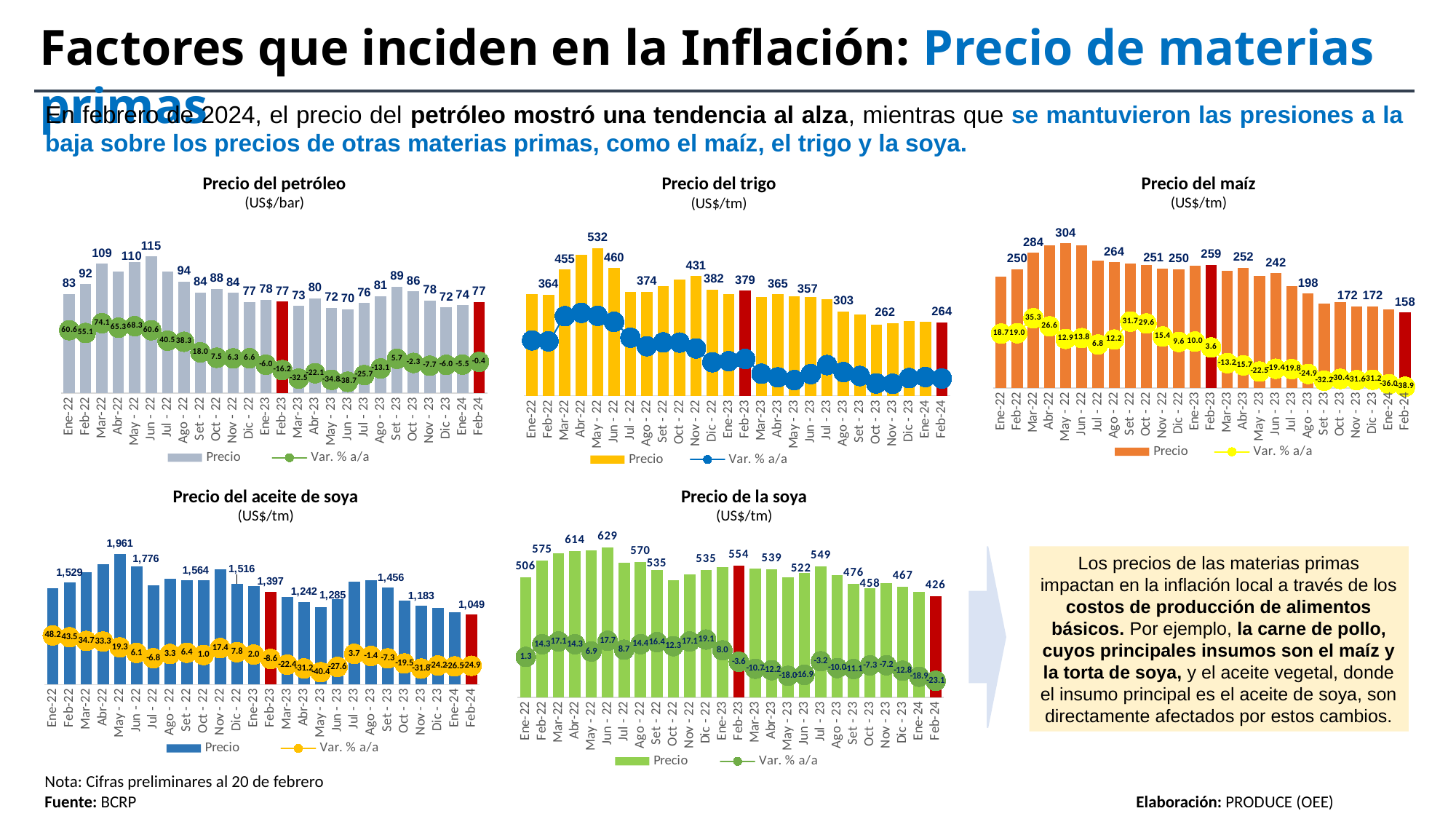
In the 'Precio del maíz' chart, what is the price for Feb-23 (the red bar)? 259 In the 'Precio del maíz' chart, what is the Var. % a/a value for Feb-24? -38.9 In the 'Precio de la soya' chart, what is the highest labelled price? 629 In the 'Precio del maíz' chart, do the prices generally rise or fall from Feb-23 to Feb-24? Fall In the 'Precio de la soya' chart, which is larger: the price for Feb-23 or the price for Feb-24? Feb-23 How many series does the legend of the 'Precio del trigo' chart list? 2 In the 'Precio del aceite de soya' chart, what is the Var. % a/a value for Feb-24? -24.9 In the 'Precio del maíz' chart, what is the difference between the Feb-23 price (259) and the Feb-24 price (158)? 101 In the 'Precio del aceite de soya' chart, what is the highest labelled price? 1,961 In the 'Precio del petróleo' chart, what is the price for Feb-24? 77 In the 'Precio del trigo' chart, what is the price for Feb-24? 264 What kind of chart is used for the 'Precio' series in the 'Precio del petróleo' chart? Bar chart